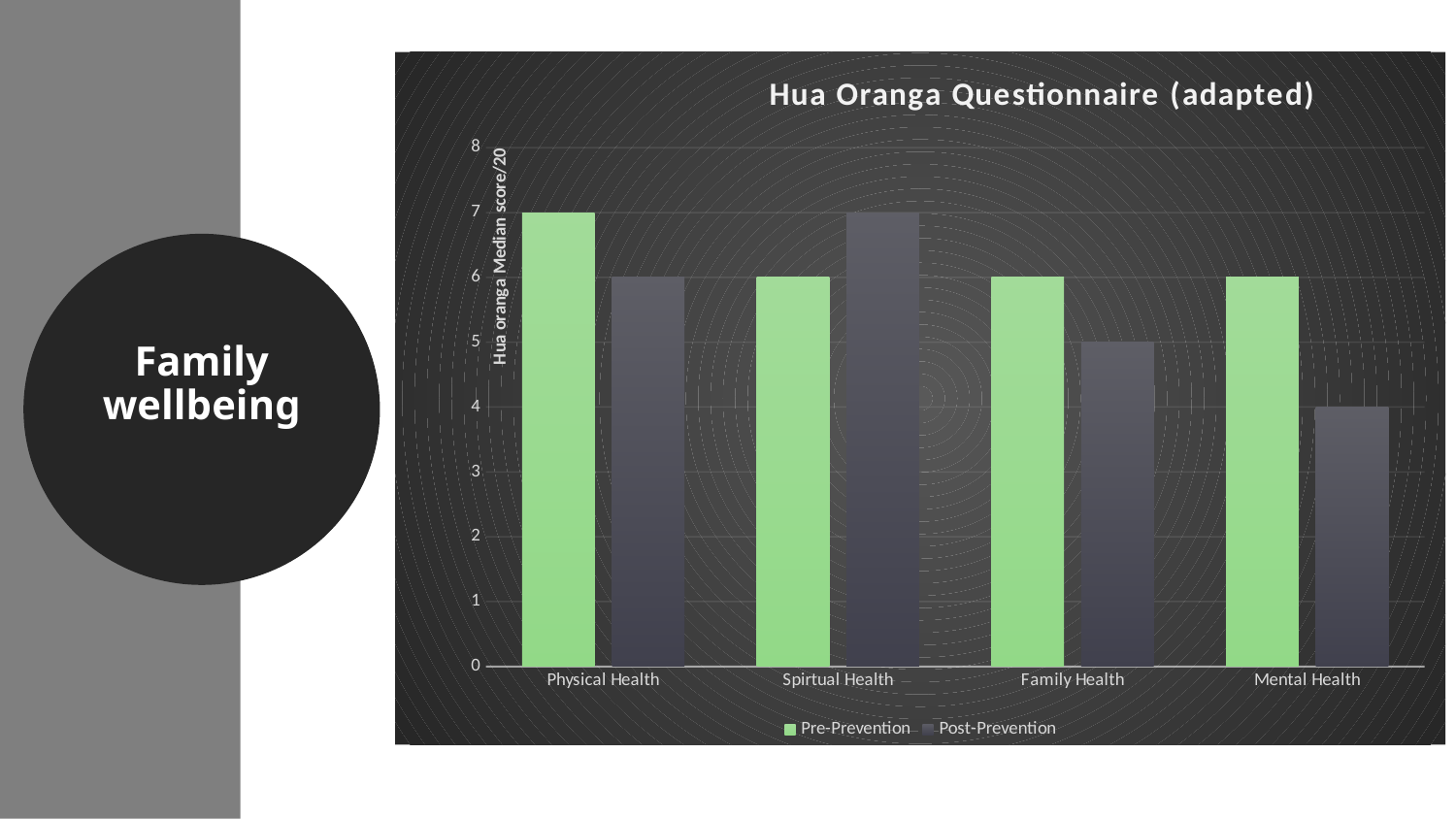
How many series does the legend list? 2 What is the title of the chart? Hua Oranga Questionnaire (adapted) For Spirtual Health, which is larger: the Pre-Prevention or the Post-Prevention value? Post-Prevention Which category has the lowest Post-Prevention value? Mental Health What is the Post-Prevention value for Mental Health? 4 What is the Pre-Prevention value for Physical Health? 7 What is the Post-Prevention value for Spirtual Health? 7 What is the difference between the Pre-Prevention and Post-Prevention values for Mental Health? 2 Which category has the highest Pre-Prevention value? Physical Health What is the Post-Prevention value for Family Health? 5 What kind of chart is shown on the slide? Bar chart How many categories are shown on the x axis? 4